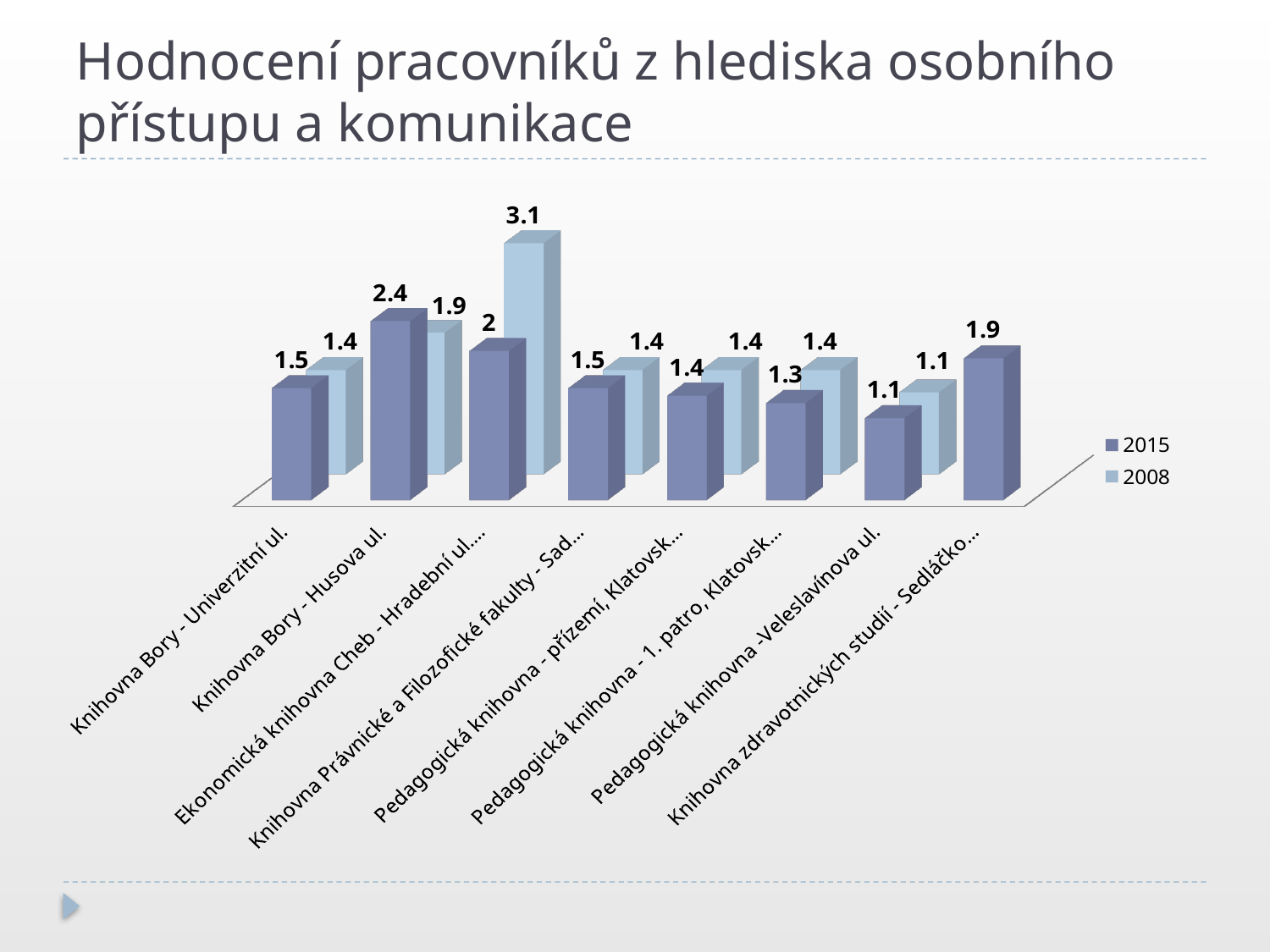
What kind of chart is shown on the slide? Bar chart What is the difference between the 2008 and 2015 values for Ekonomická knihovna Cheb? 1.1 How many series does the legend list? 2 What is the 2008 value for Ekonomická knihovna Cheb? 3.1 For Knihovna Bory - Husova ul., which is larger: the 2015 value or the 2008 value? 2015 What is the 2015 value for Knihovna zdravotnických studií? 1.9 How many categories are shown on the x axis? 8 What is the 2015 value for Knihovna Bory - Husova ul.? 2.4 Which category has the highest 2015 value? Knihovna Bory - Husova ul. What is the 2015 value for Pedagogická knihovna - Veleslavínova ul.? 1.1 Which category has the highest 2008 value? Ekonomická knihovna Cheb Which category has the lowest 2015 value? Pedagogická knihovna - Veleslavínova ul.